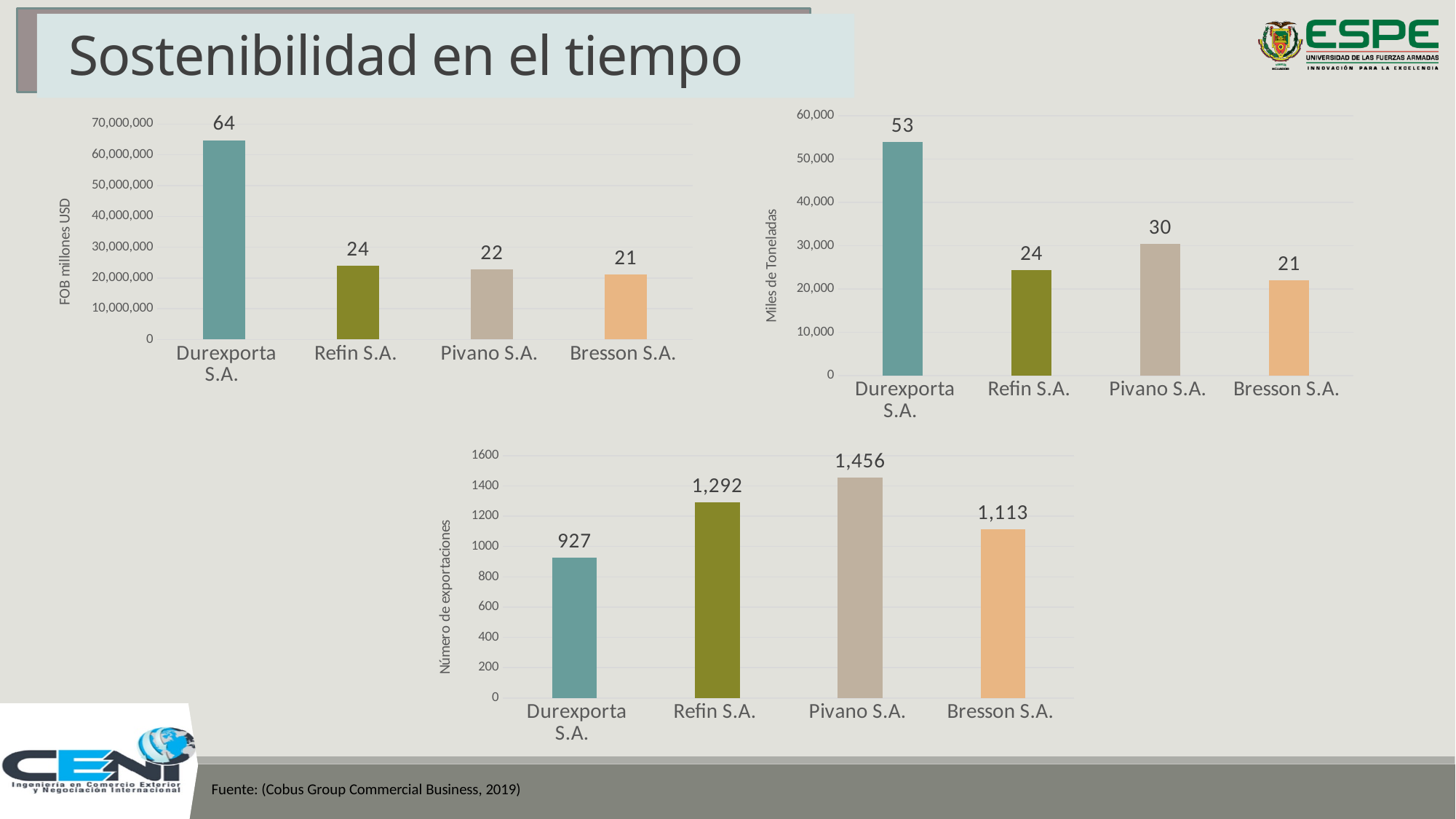
In the top-right chart (Miles de Toneladas), is the value for Refin S.A. greater or less than Pivano S.A.? less In the bottom chart (Número de exportaciones), which company has the highest value? Pivano S.A. In the top-right chart (Miles de Toneladas), which company has the highest value? Durexporta S.A. What type of chart is the top-left chart (FOB millones USD)? Bar chart In the bottom chart (Número de exportaciones), what is the data label for Refin S.A.? 1,292 In the bottom chart (Número de exportaciones), which company has the lowest value? Durexporta S.A. How many companies are shown in the bottom chart (Número de exportaciones)? 4 In the top-left chart (FOB millones USD), what is the data label for Durexporta S.A.? 64 In the top-left chart (FOB millones USD), which company has the lowest value? Bresson S.A. In the bottom chart (Número de exportaciones), what is the difference between Pivano S.A. and Bresson S.A.? 343 In the top-left chart (FOB millones USD), what is the difference between the labels for Durexporta S.A. and Refin S.A.? 40 In the top-right chart (Miles de Toneladas), what is the data label for Pivano S.A.? 30